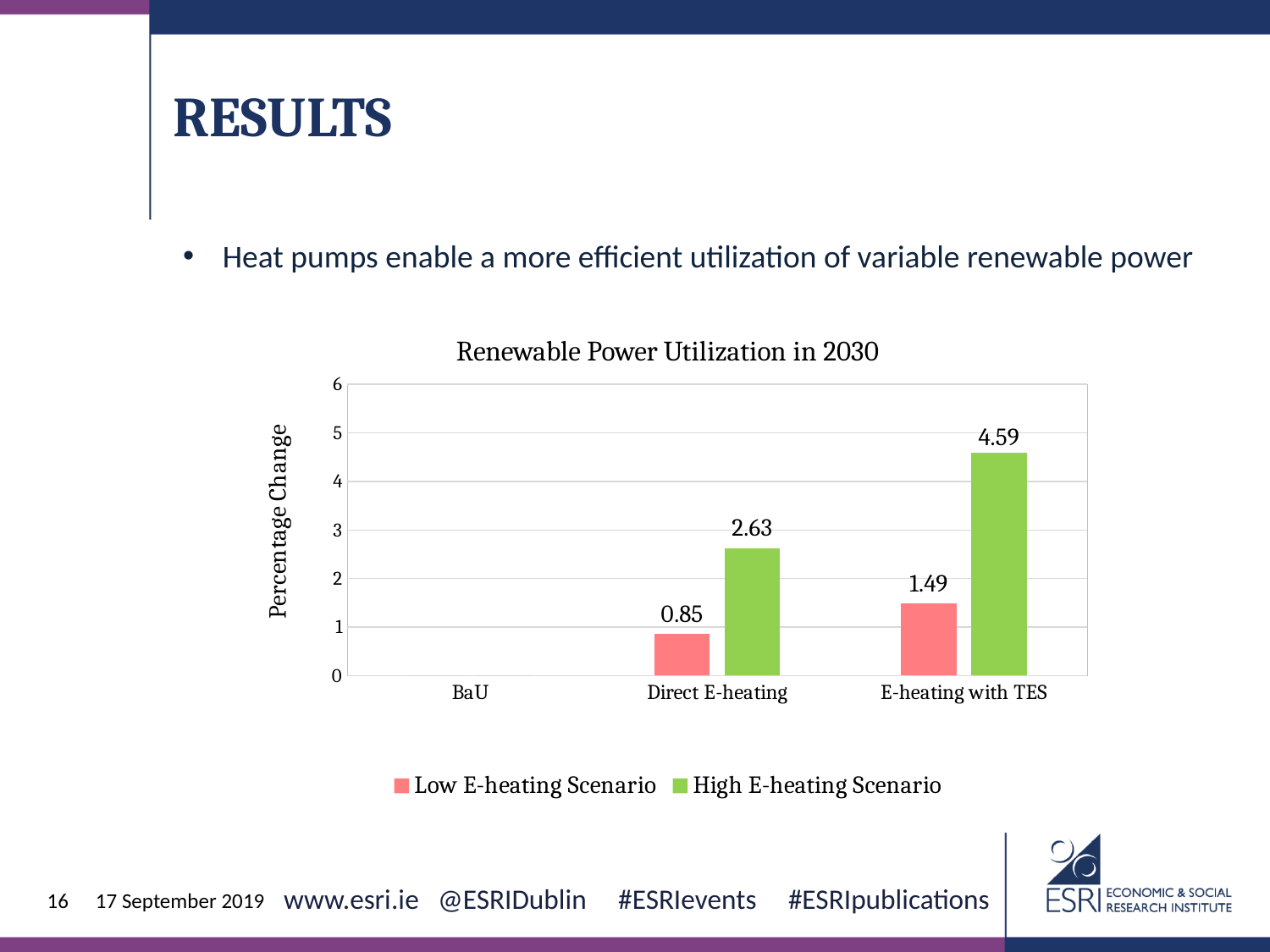
What is the value for the Low E-heating Scenario in the E-heating with TES category? 1.49 Which is larger: the Low E-heating Scenario value for E-heating with TES or the High E-heating Scenario value for Direct E-heating? High E-heating Scenario value for Direct E-heating What is the difference between the High and Low E-heating Scenario values in the E-heating with TES category? 3.10 How many series does the legend list? 2 What kind of chart is shown on the slide? Bar chart What is the value for the High E-heating Scenario in the E-heating with TES category? 4.59 What is the difference between the High E-heating Scenario values for E-heating with TES and Direct E-heating? 1.96 What is the value for the High E-heating Scenario in the Direct E-heating category? 2.63 How many categories are shown on the x axis? 3 What is the title of the chart? Renewable Power Utilization in 2030 Which category has the highest value for the High E-heating Scenario? E-heating with TES What is the value for the Low E-heating Scenario in the Direct E-heating category? 0.85